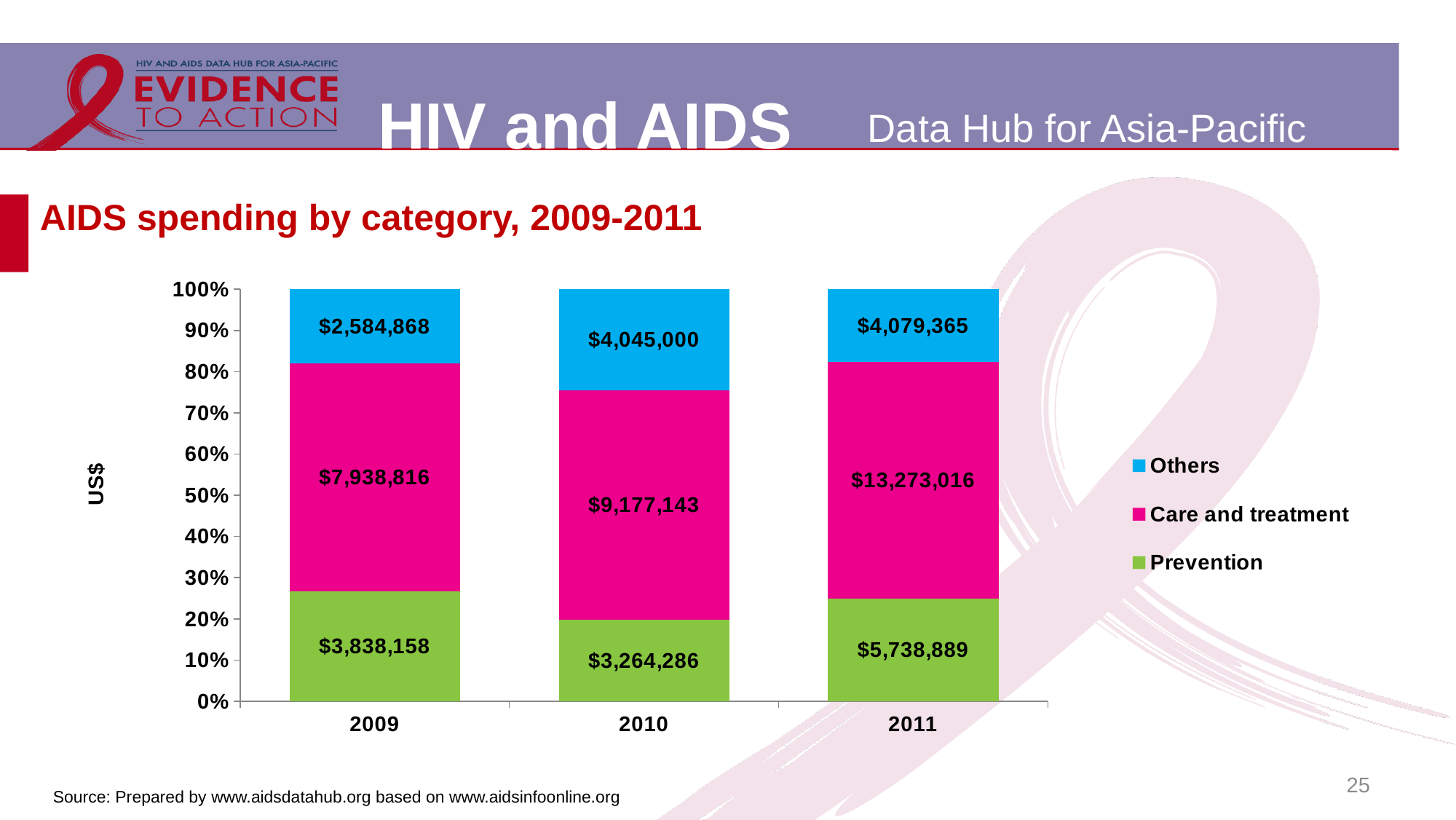
What was the Prevention spending in 2010? $3,264,286 Is the share of Care and treatment in 2009 greater or less than 50%? greater In which year was Prevention spending lowest? 2010 How many years are shown on the x axis? 3 What was the total AIDS spending across all three categories in 2009? $14,361,842 What kind of chart is shown on the slide? Stacked bar chart How much more was spent on Care and treatment in 2011 than in 2010? $4,095,873 In which year was Care and treatment spending highest? 2011 What was the Care and treatment spending in 2011? $13,273,016 How many series does the legend list? 3 What was the Others spending in 2009? $2,584,868 Which was larger in 2010: Others spending or Prevention spending? Others